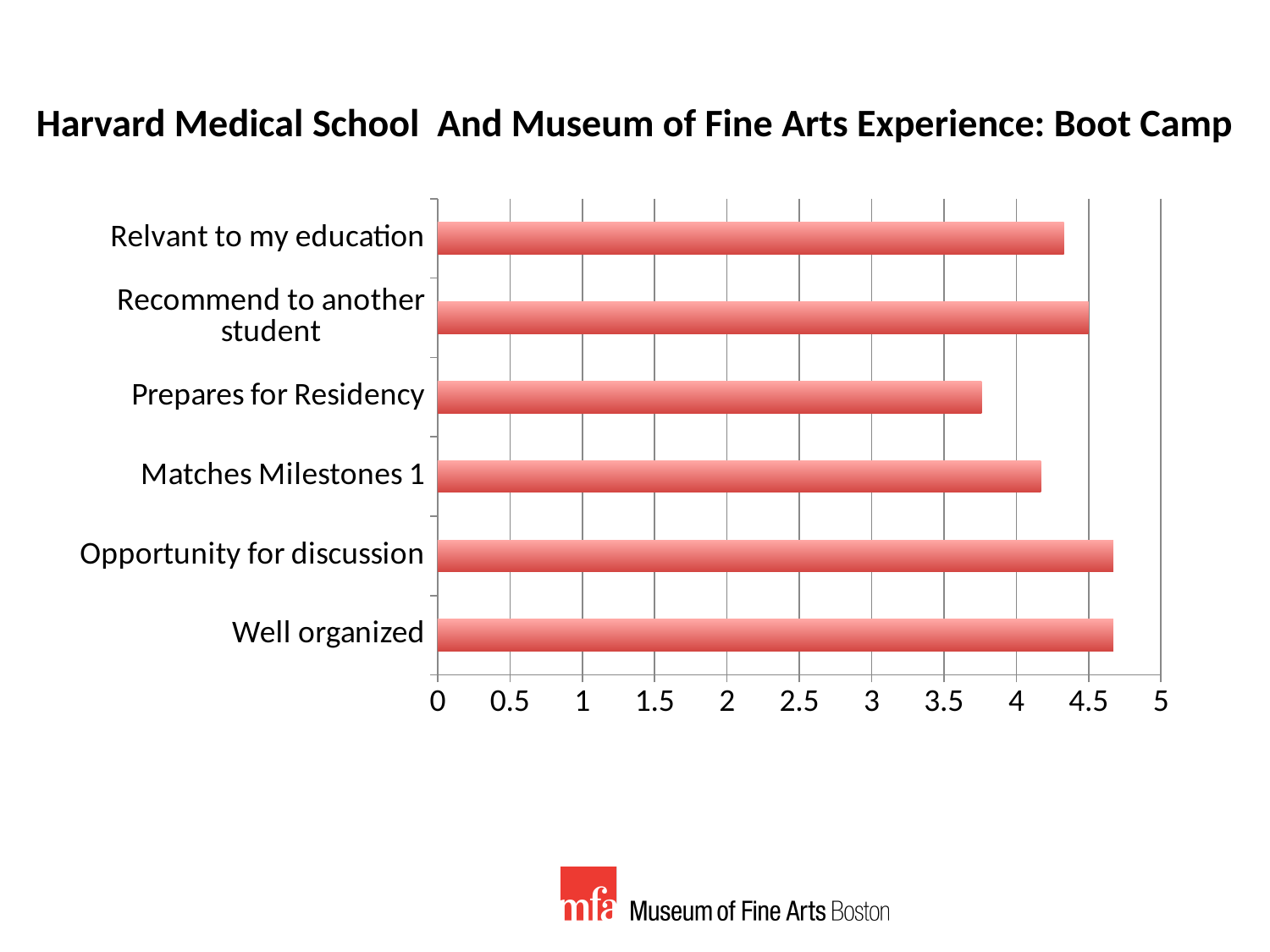
Is the value for Opportunity for discussion greater or less than 4.5? greater Is the value for Relvant to my education greater or less than 4? greater Is the value for Prepares for Residency greater or less than 4? less Which category has the lowest value? Prepares for Residency How many categories are shown in the chart? 6 What is the maximum value shown on the horizontal axis? 5 Which is larger, the value for Opportunity for discussion or the value for Matches Milestones 1? Opportunity for discussion What is the title of the chart? Harvard Medical School And Museum of Fine Arts Experience: Boot Camp Which is larger, the value for Recommend to another student or the value for Prepares for Residency? Recommend to another student What kind of chart is shown on the slide? bar chart